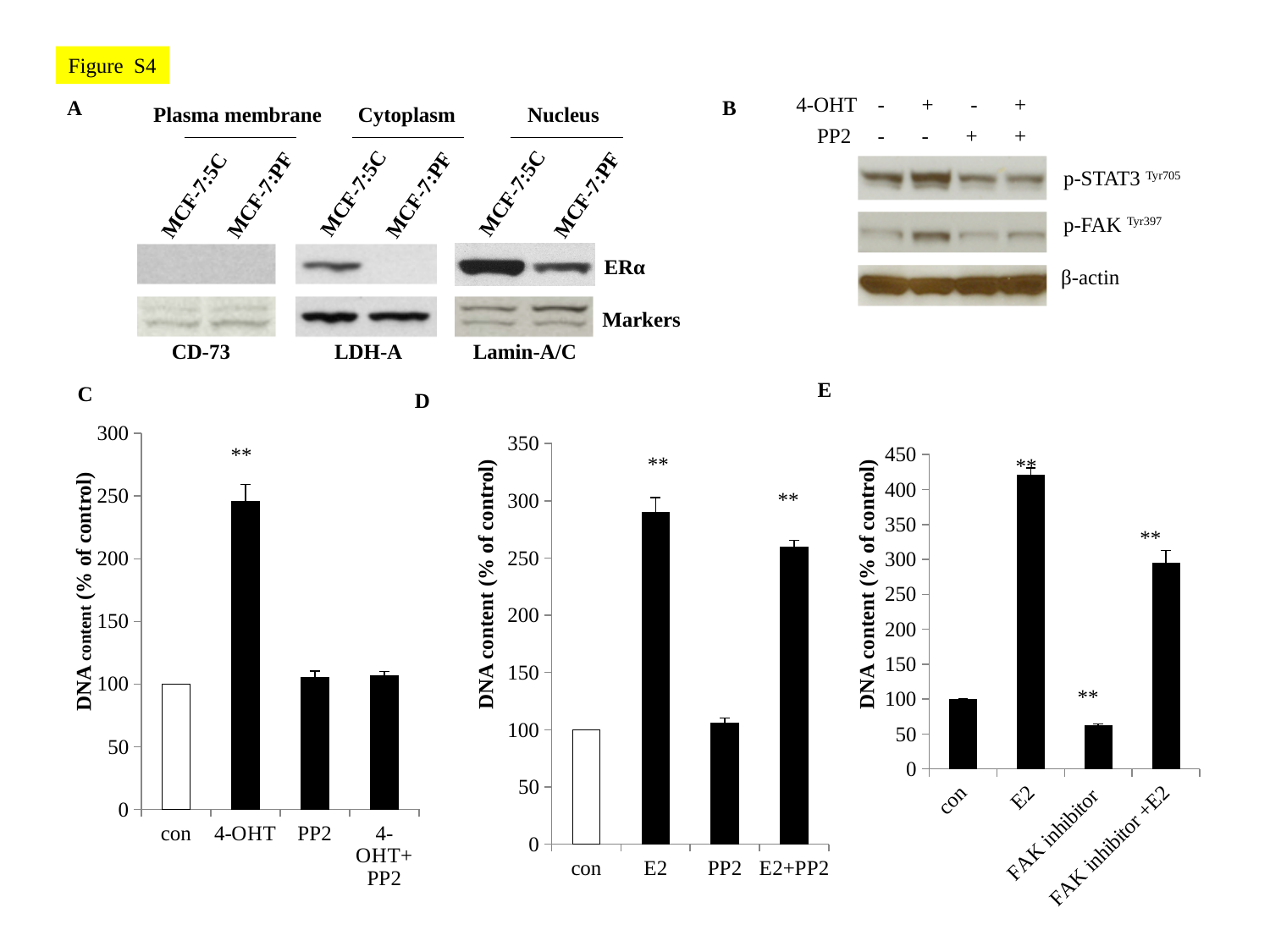
In chart E, is the value for FAK inhibitor greater or less than 100? less In chart E, which category has the lowest DNA content? FAK inhibitor In chart D, is the value for PP2 greater or less than 150? less In chart C, is the value for 4-OHT greater or less than 200? greater In chart C, which category has the highest DNA content? 4-OHT In chart C, what is the DNA content (% of control) for con? 100 In chart E, which category has the highest DNA content? E2 In chart C, how many categories are shown on the x axis? 4 What kind of chart is chart E? bar chart In chart D, which category has the highest DNA content? E2 In chart D, which is larger, the value for E2 or the value for E2+PP2? E2